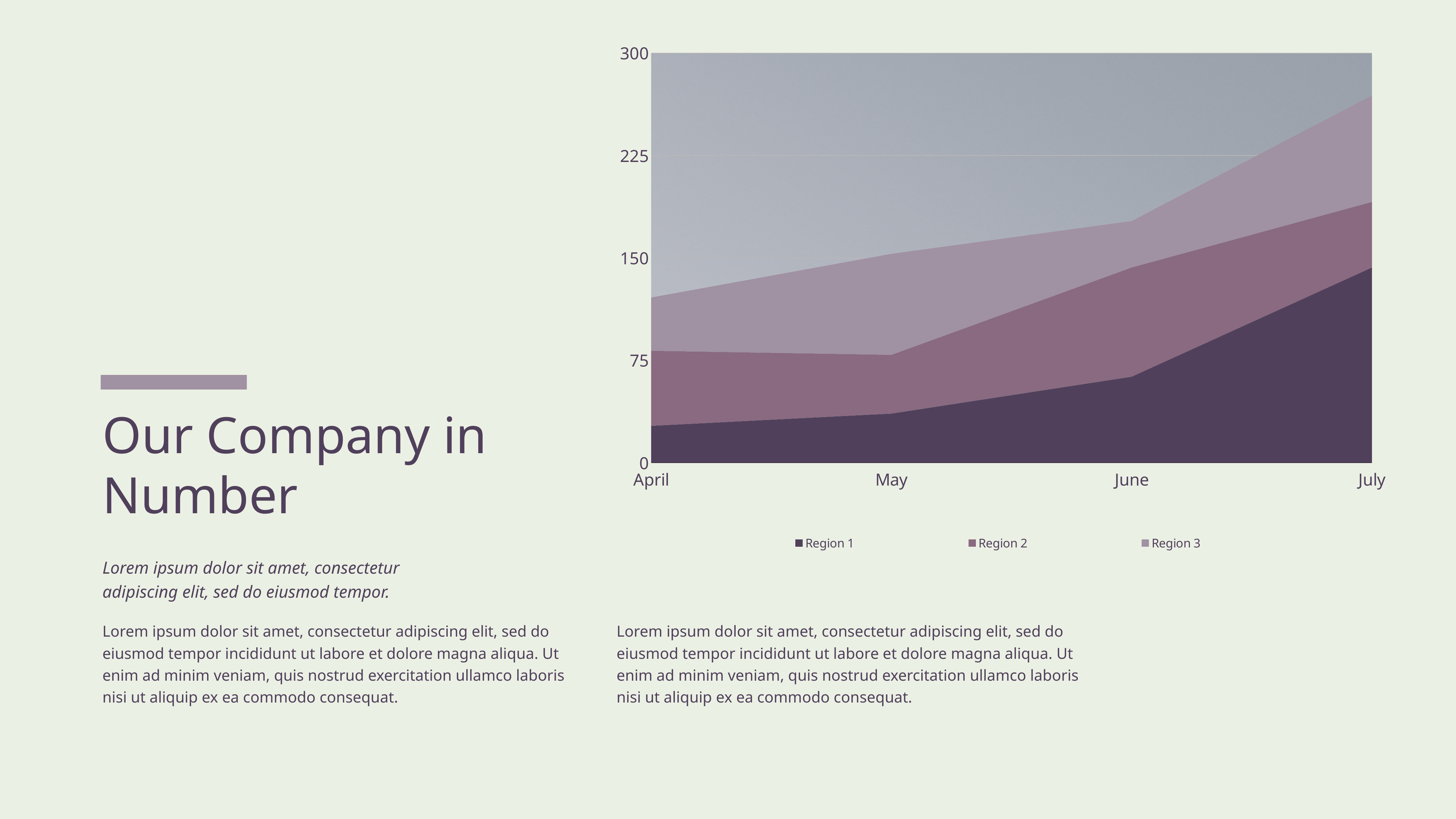
Does the value for Region 1 rise or fall from April to July? rise Is the stacked total of all three regions in April greater or less than 150? less What kind of chart is shown on the slide? Stacked area chart In which month does Region 1 reach its highest value? July How many months are shown along the x axis of the chart? 4 Which series is plotted as the bottom (darkest) layer of the chart? Region 1 Is the value for Region 1 in July greater or less than 75? greater What are the names of the series listed in the chart legend? Region 1, Region 2, Region 3 Is the value for Region 1 in April greater or less than 75? less How many series does the chart legend list? 3